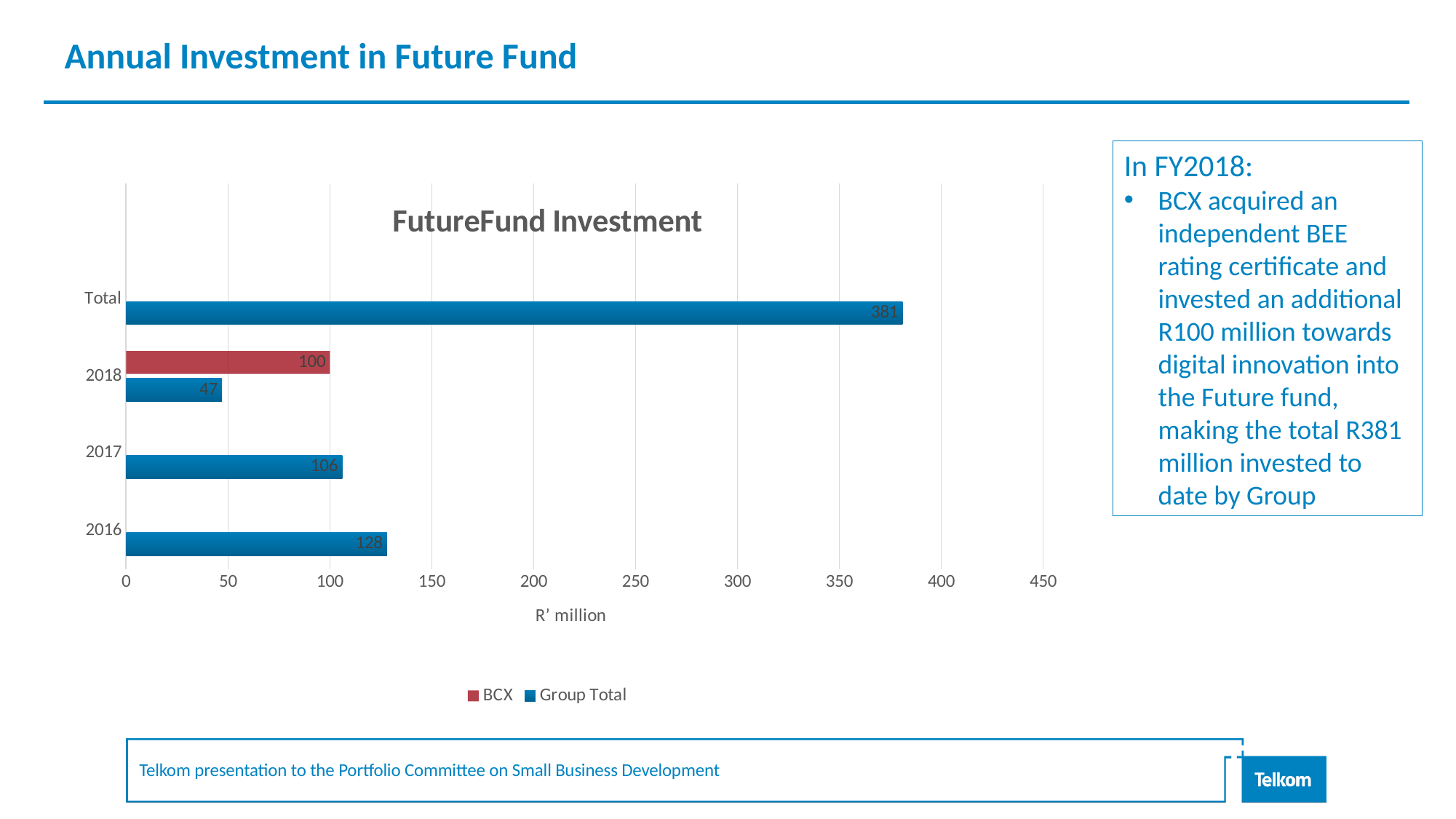
What is the value of the Total bar? 381 What is the Group Total value for 2016? 128 What kind of chart is shown? Bar chart In 2018, which is larger, the BCX value or the Group Total value? BCX What is the Group Total value for 2018? 47 Which year has the lowest Group Total value? 2018 What is the title of the chart? FutureFund Investment Which year has the highest Group Total value? 2016 How many series does the legend list? 2 What is the BCX value for 2018? 100 What is the Group Total value for 2017? 106 What is the difference between the Group Total values for 2016 and 2017? 22